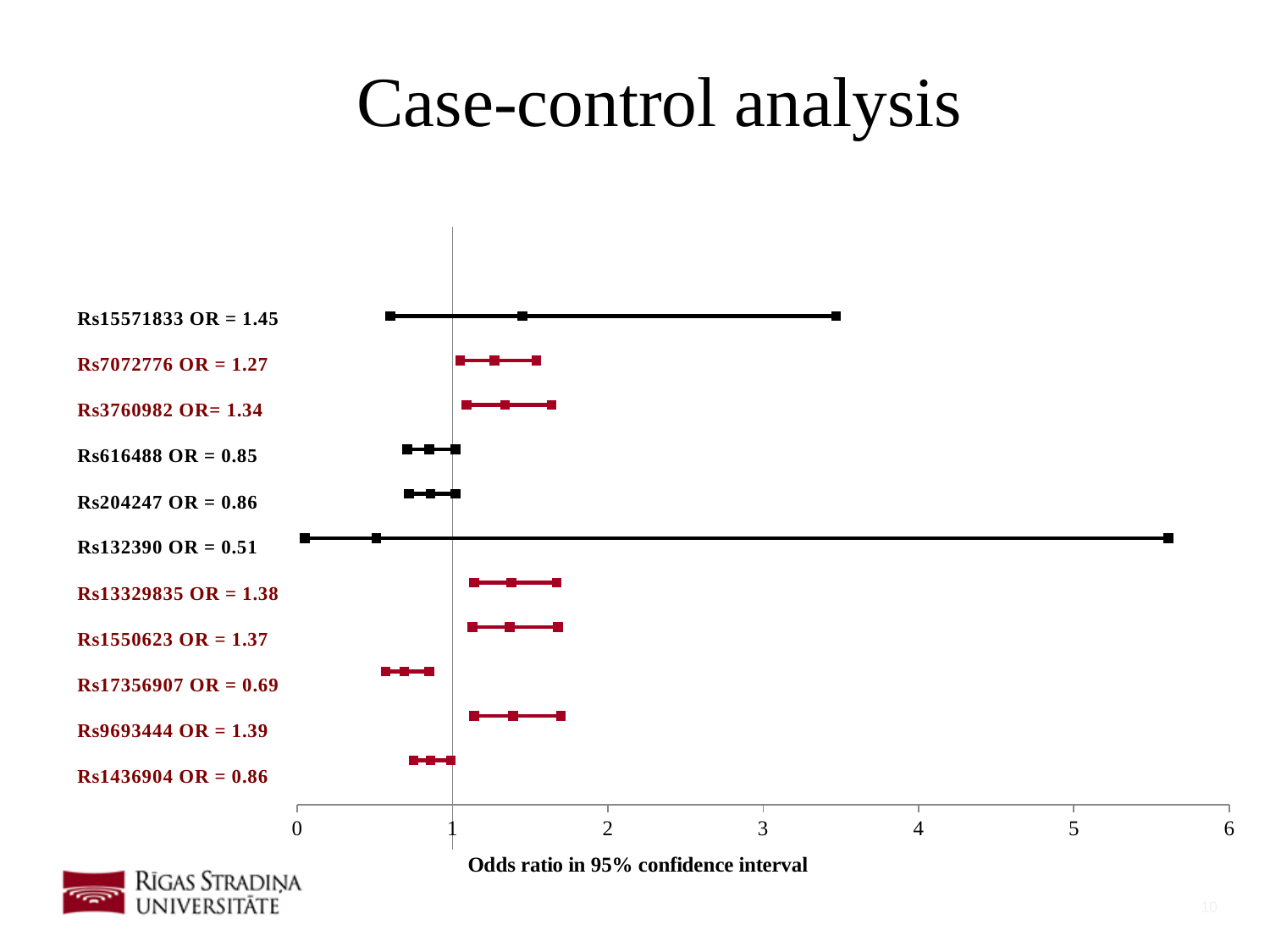
Is the upper confidence limit for Rs15571833 greater or less than 3? greater Which has a larger odds ratio, Rs7072776 or Rs3760982? Rs3760982 What is the odds ratio for Rs15571833? 1.45 How many SNPs are plotted on the chart? 11 Which SNP has the highest odds ratio? Rs15571833 Is the upper confidence limit for Rs132390 greater or less than 5? greater What is the odds ratio for Rs17356907? 0.69 What is the difference between the odds ratios of Rs15571833 and Rs132390? 0.94 What kind of chart is shown on the slide? Forest plot What is the title of the horizontal axis? Odds ratio in 95% confidence interval What is the odds ratio for Rs132390? 0.51 Which SNP has the lowest odds ratio? Rs132390